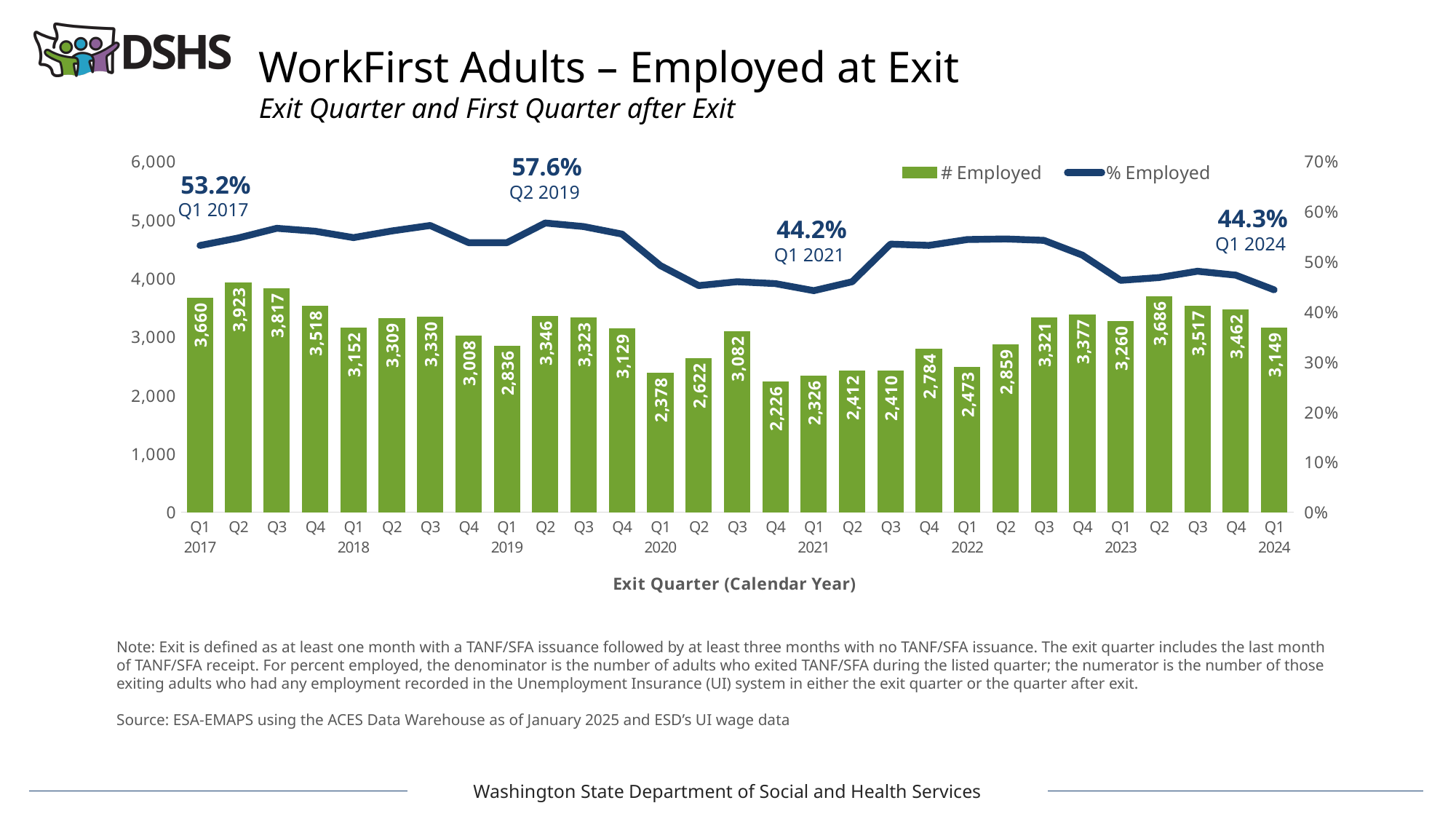
Which is larger, the # Employed in Q2 2023 or in Q1 2024? Q2 2023 Which quarter has the highest number employed? Q2 2017 Which quarter has the lowest number employed? Q4 2020 What is the # Employed value for Q4 2020? 2,226 What percent of WorkFirst adults were employed at exit in Q2 2019? 57.6% What is the difference in # Employed between Q2 2017 and Q4 2020? 1,697 How many quarters are plotted on the x axis? 29 How many adults were employed at exit in Q2 2017? 3,923 What is the x-axis title of the chart? Exit Quarter (Calendar Year) Is the % Employed value for Q2 2020 greater or less than 50%? less How many series does the legend list? 2 What is the % Employed value labeled for Q1 2024? 44.3%